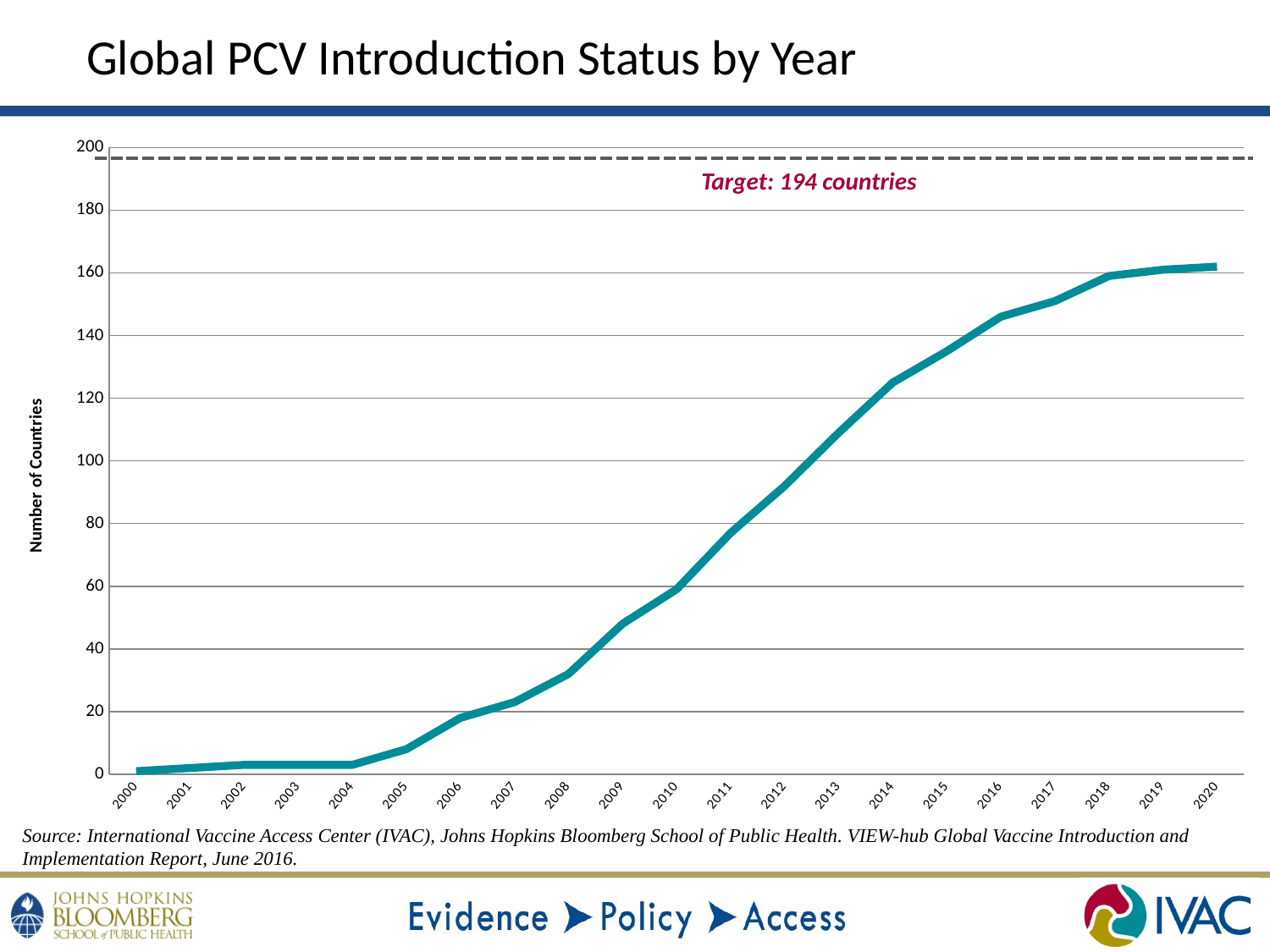
Which year has the larger value, 2010 or 2015? 2015 Which year has the lowest number of countries? 2000 What kind of chart is shown on the slide? line chart Is the value for 2012 greater or less than 100? less What is the label of the y axis? Number of Countries Is the value for 2016 greater or less than 140? greater Which year has the highest number of countries? 2020 Is the value for 2005 greater or less than 20? less What target is marked by the dashed line on the chart? 194 countries Do the values rise or fall from 2000 to 2020? rise How many years are plotted along the x axis? 21